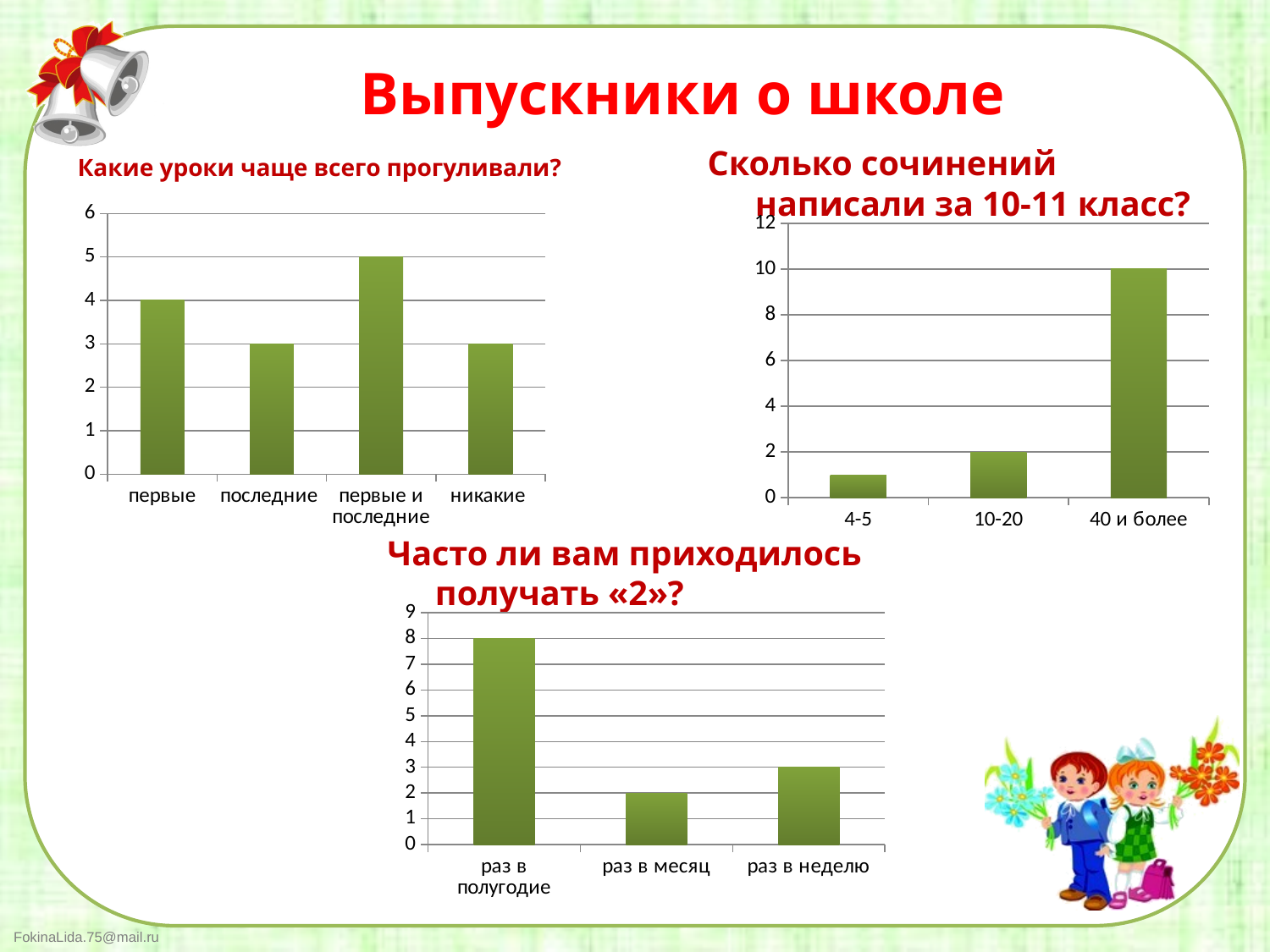
In the chart "Часто ли вам приходилось получать «2»?", what is the difference between the values for "раз в полугодие" and "раз в месяц"? 6 What type of chart is the chart "Часто ли вам приходилось получать «2»?"? bar chart In the chart "Какие уроки чаще всего прогуливали?", which category has the highest value? первые и последние In the chart "Часто ли вам приходилось получать «2»?", what is the value for "раз в полугодие"? 8 In the chart "Часто ли вам приходилось получать «2»?", which is larger, the value for "раз в месяц" or "раз в неделю"? раз в неделю In the chart "Сколько сочинений написали за 10-11 класс?", which category has the lowest value? 4-5 In the chart "Сколько сочинений написали за 10-11 класс?", what is the value for "40 и более"? 10 In the chart "Сколько сочинений написали за 10-11 класс?", do the values rise or fall from left to right along the x axis? rise In the chart "Какие уроки чаще всего прогуливали?", how many categories are shown on the x axis? 4 In the chart "Какие уроки чаще всего прогуливали?", what is the difference between the values for "первые" and "последние"? 1 In the chart "Какие уроки чаще всего прогуливали?", what is the value for "первые и последние"? 5 In the chart "Сколько сочинений написали за 10-11 класс?", is the value for "40 и более" greater or less than 8? greater